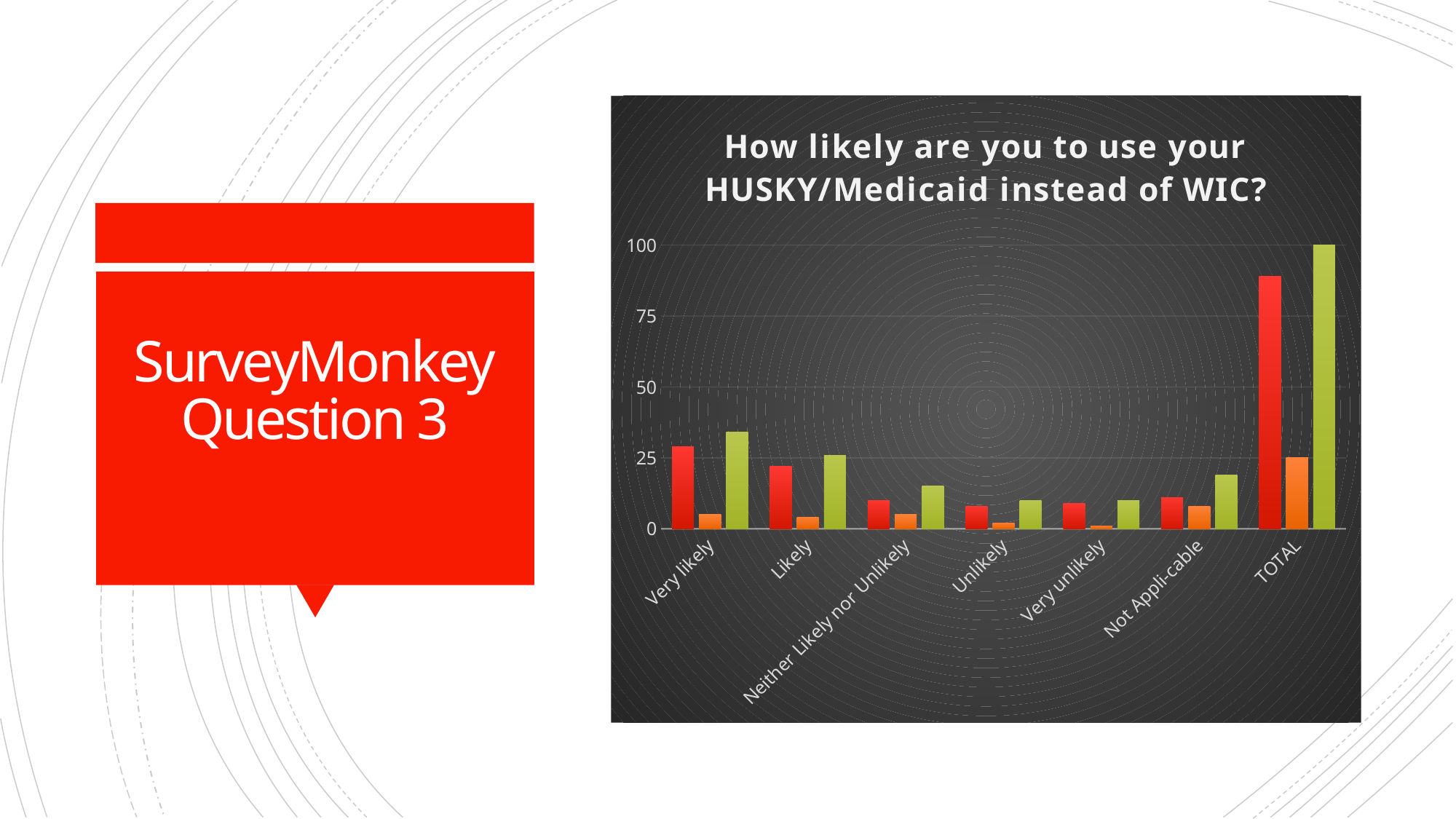
How many categories are shown along the x axis of the chart? 7 What kind of chart is shown on the slide? bar chart Excluding TOTAL, which category has the tallest green bar? Very likely Which category has the tallest green bar? TOTAL Do the red bars generally rise or fall from Very likely to Very unlikely? fall Which is larger, the red bar for Very likely or the red bar for Likely? Very likely Is the value of the green bar for Not Appli-cable greater or less than 25? less Is the value of the red bar for Neither Likely nor Unlikely greater or less than 25? less What is the title of the chart? How likely are you to use your HUSKY/Medicaid instead of WIC? Is the value of the green bar for Very likely greater or less than 25? greater How many bars are plotted for each category in the chart? 3